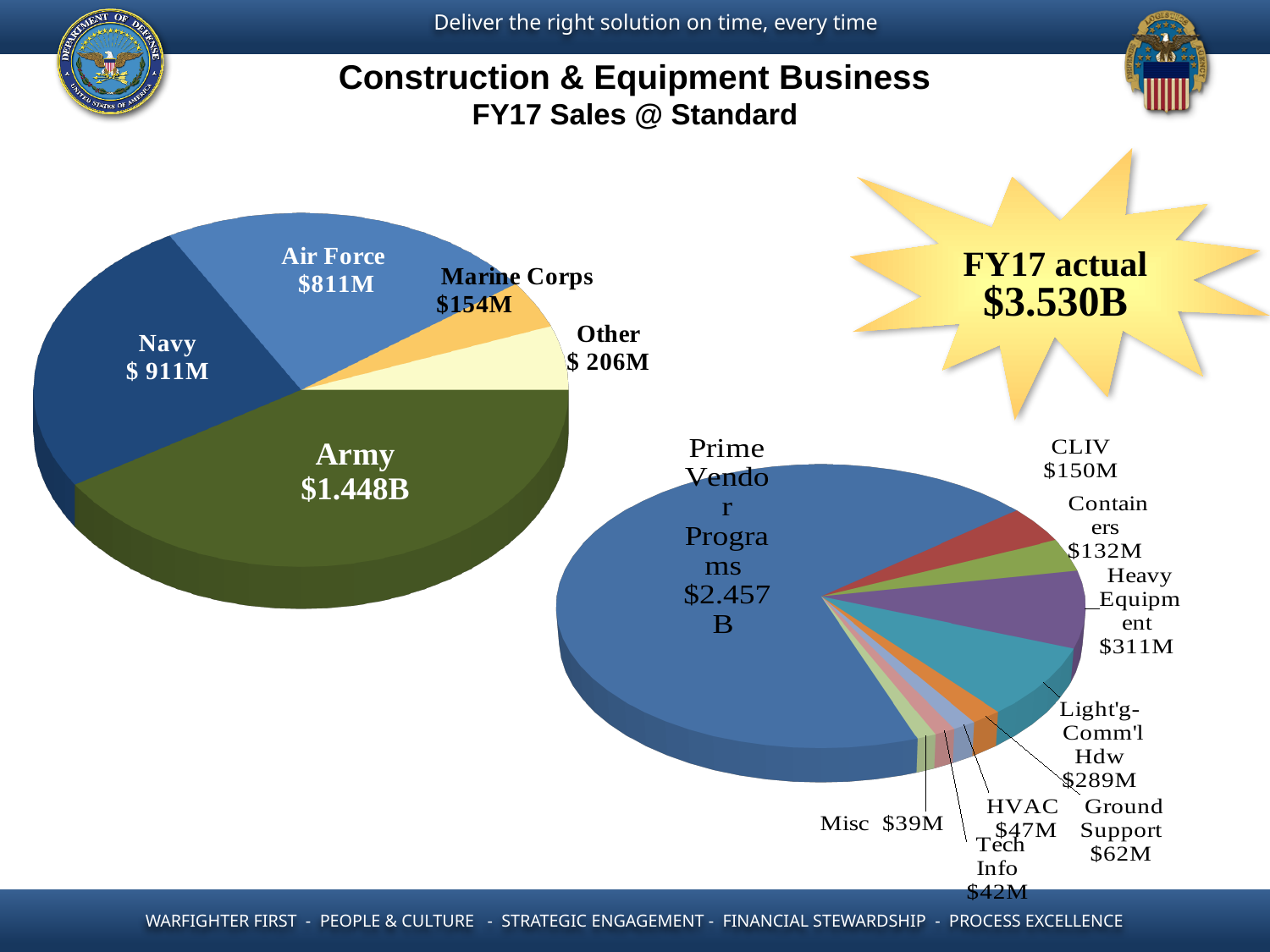
How many categories are shown in the left pie chart? 5 In the left pie chart, which is larger, Other or Marine Corps? Other In the right pie chart, which category has the largest value? Prime Vendor Programs In the right pie chart, what is the difference between Heavy Equipment and Light'g-Comm'l Hdw? $22M In the left pie chart, what is the value for Army? $1.448B In the left pie chart, what is the difference between the Navy and Air Force values? $100M In the right pie chart, which category has the smallest value? Misc In the left pie chart, what is the value for Navy? $ 911M In the left pie chart, which category has the smallest value? Marine Corps In the right pie chart, what is the value for Heavy Equipment? $311M What type of chart is the left chart showing sales by military service? pie chart How many categories are shown in the right pie chart? 9